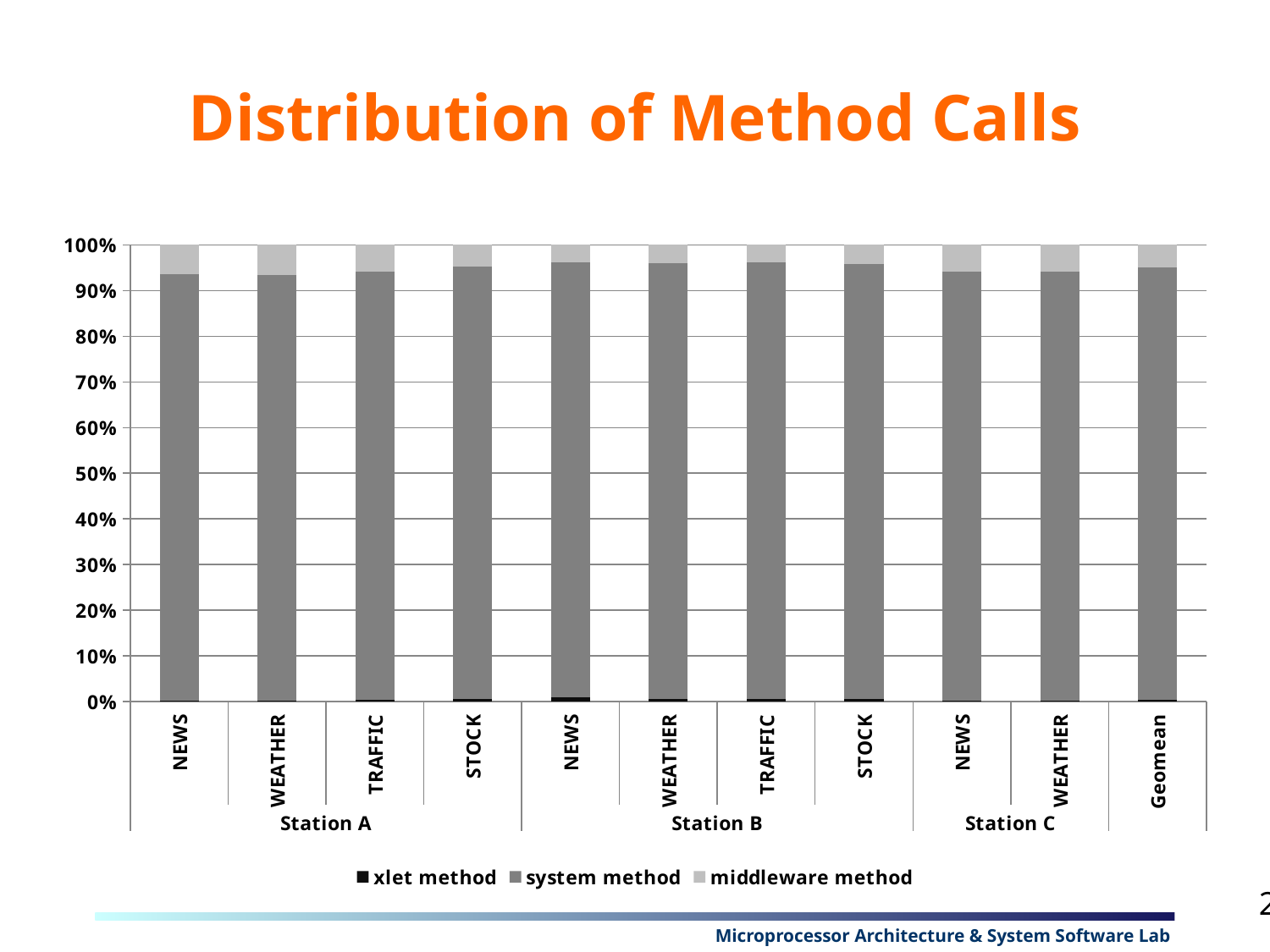
What is the title of the chart? Distribution of Method Calls How many station groups are shown on the x axis? 3 Which series takes up the smallest share of the bar for Station B WEATHER? xlet method Is the system method share for Station A TRAFFIC greater or less than 90%? greater How many series does the legend list? 3 How many bars are plotted in the chart? 11 Which series takes up the largest share of the bar for Station A NEWS? system method What kind of chart is shown on the slide? stacked bar chart Is the middleware method share for Station C NEWS greater or less than 10%? less What are the three series named in the legend? xlet method, system method, middleware method For the Geomean bar, which is larger: the system method share or the middleware method share? system method What is the total height of the stacked bar for Station B STOCK? 100%